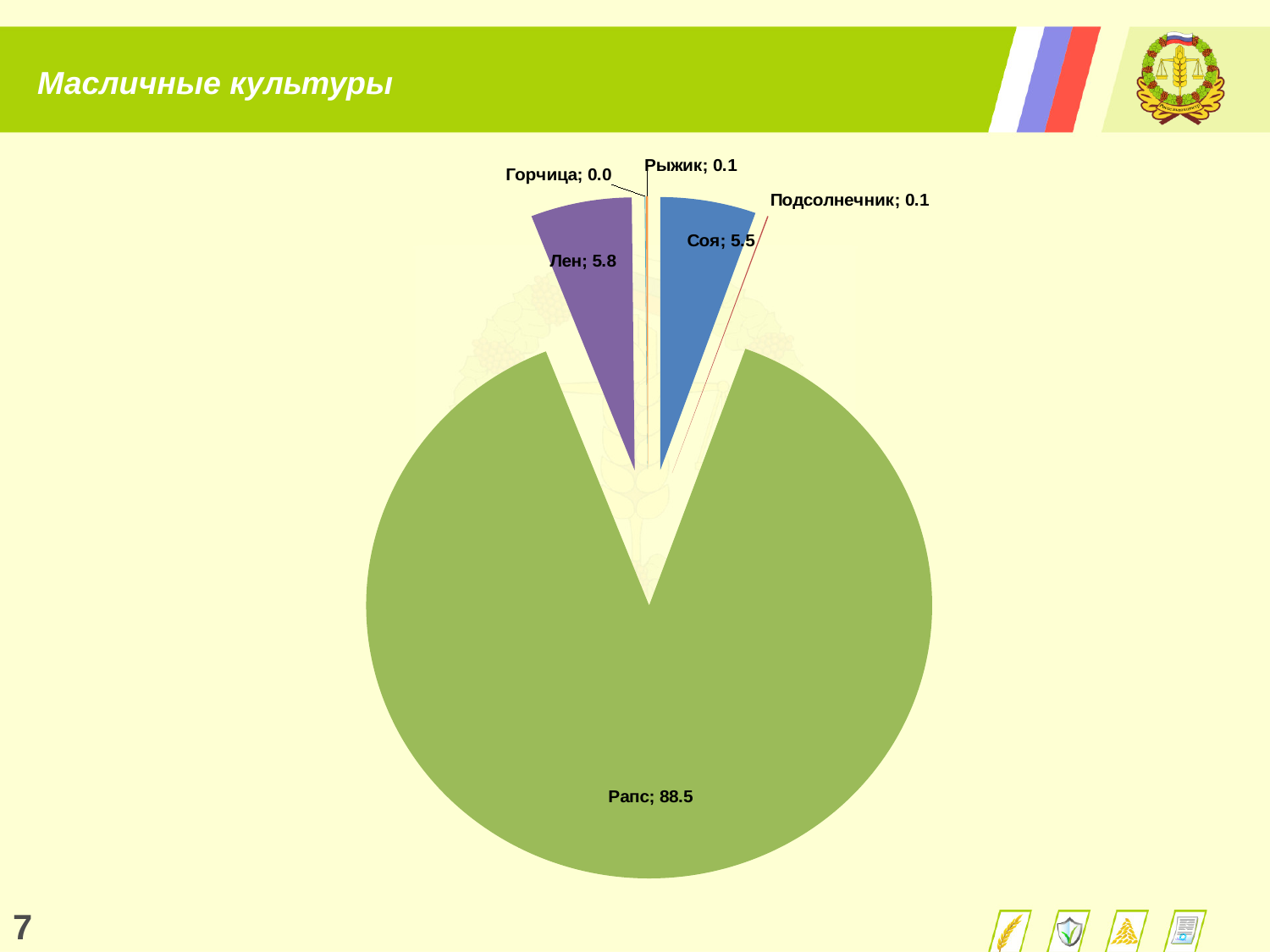
What is the title of the slide containing the pie chart? Масличные культуры What is the value shown for Лен? 5.8 Which is larger, the value for Лен or the value for Соя? Лен Which category has the smallest value in the pie chart? Горчица What type of chart is shown on the slide? pie chart Which category has the largest slice of the pie? Рапс What is the value shown for Соя? 5.5 How many categories are shown in the pie chart? 6 What is the value shown for Рапс? 88.5 What is the value shown for Горчица? 0.0 What is the value shown for Подсолнечник? 0.1 What is the difference between the values for Лен and Соя? 0.3